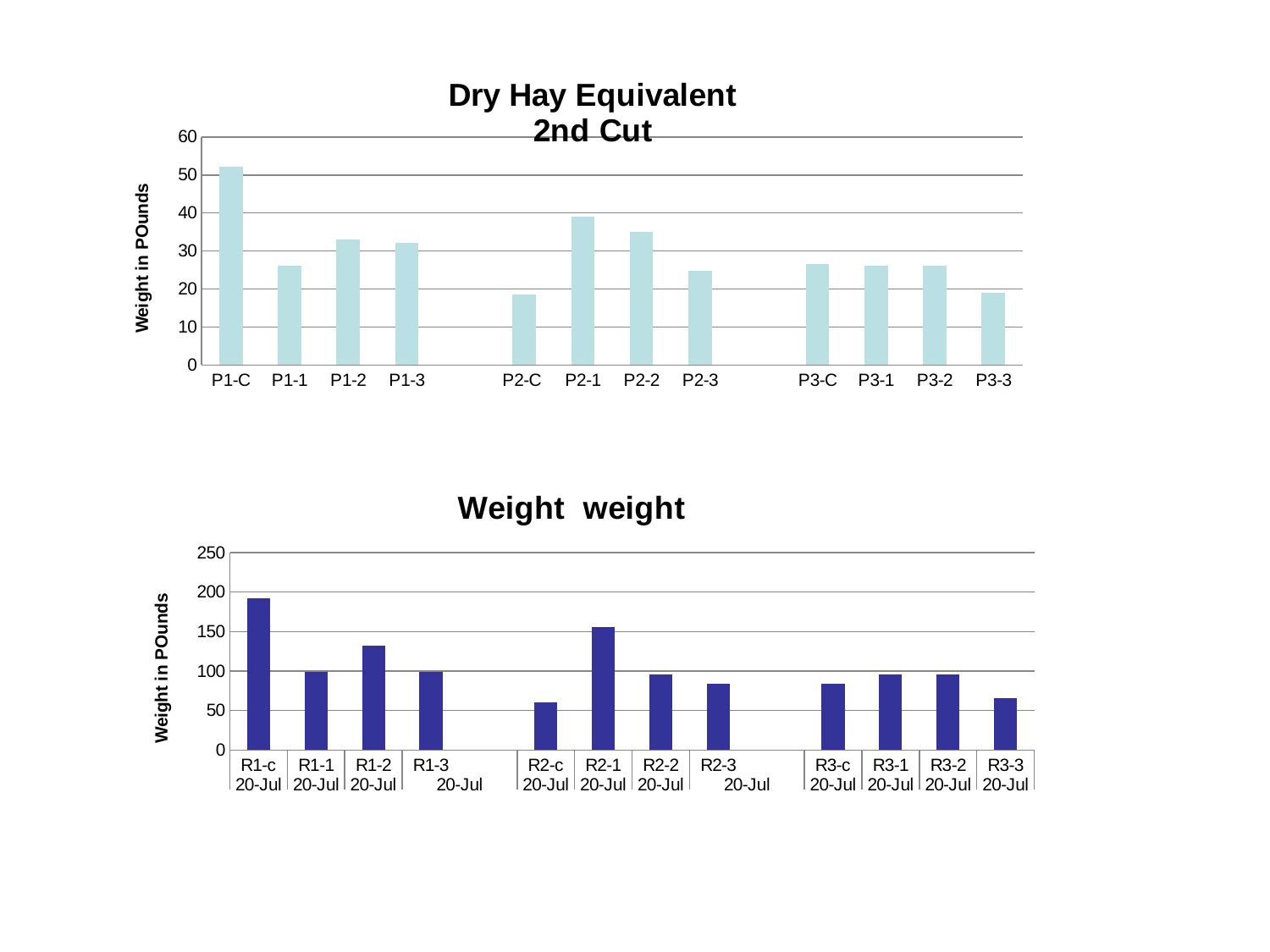
What is the y-axis label of the 'Weight weight' chart? Weight in POunds In the 'Weight weight' chart, is the value for R2-1 greater or less than 150? greater In the 'Dry Hay Equivalent 2nd Cut' chart, which is larger, the value for P2-1 or the value for P2-3? P2-1 In the 'Dry Hay Equivalent 2nd Cut' chart, is the value for P1-C greater or less than 50? greater What kind of chart is the 'Dry Hay Equivalent 2nd Cut' chart? bar chart In the 'Weight weight' chart, is the value for R2-c greater or less than 100? less How many bars are plotted in the 'Weight weight' chart? 12 How many bars are plotted in the 'Dry Hay Equivalent 2nd Cut' chart? 12 In the 'Weight weight' chart, which category has the highest value? R1-c In the 'Dry Hay Equivalent 2nd Cut' chart, which category has the highest value? P1-C In the 'Weight weight' chart, which is larger, the value for R1-2 or the value for R1-1? R1-2